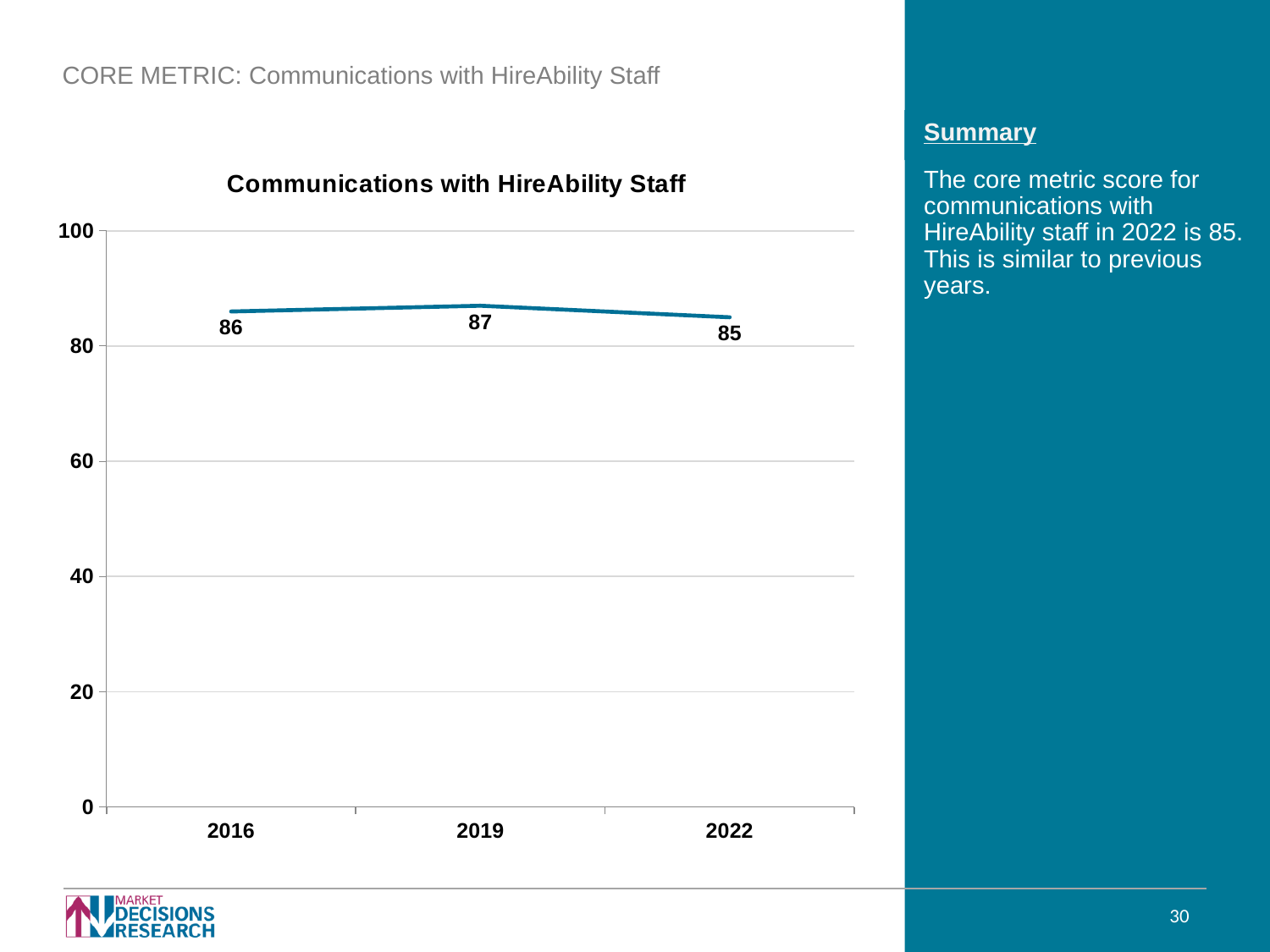
What is the difference between the values for 2019 and 2022? 2 Does the value rise or fall from 2019 to 2022? fall Which year has the highest value? 2019 Which year has the lowest value? 2022 What kind of chart is shown? line chart How many years are plotted on the chart? 3 Is the value for 2022 greater or less than 80? greater What is the value for 2016? 86 What is the value for 2022? 85 What is the title of the chart? Communications with HireAbility Staff Which is larger, the value for 2016 or the value for 2022? 2016 What is the value for 2019? 87